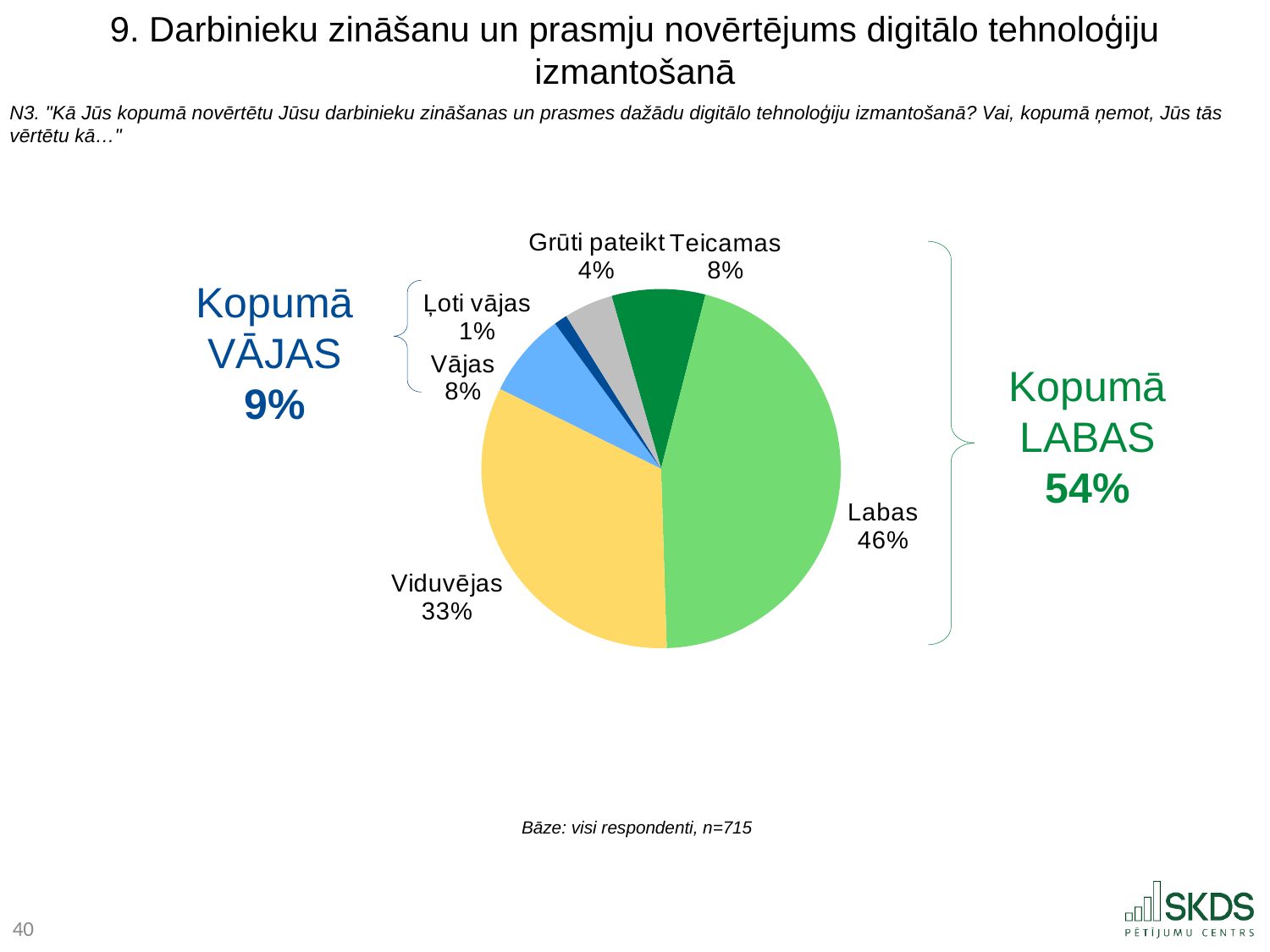
What percentage is shown for "Teicamas"? 8% What combined percentage is shown for "Kopumā LABAS"? 54% Which is larger, the "Vājas" slice or the "Grūti pateikt" slice? Vājas How many slices does the pie chart have? 6 What percentage of respondents rated their employees' skills as "Labas"? 46% What is the value of the "Viduvējas" slice? 33% Which category has the smallest slice of the pie? Ļoti vājas Which category has the largest slice of the pie? Labas What percentage is shown for "Grūti pateikt"? 4% What is the difference between the "Labas" and "Viduvējas" values? 13 percentage points What is the value of the "Ļoti vājas" slice? 1% What kind of chart is shown on the slide? pie chart